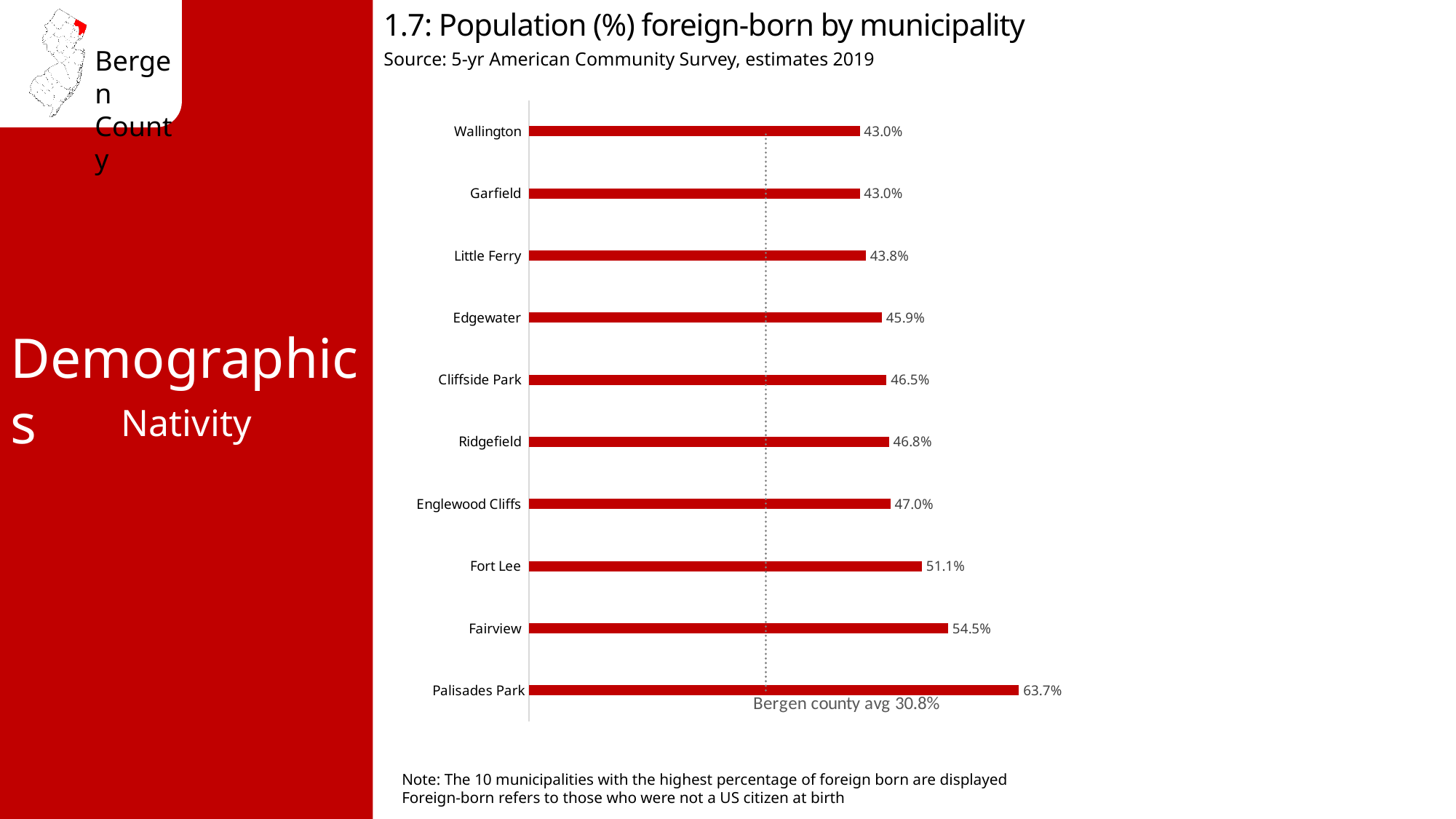
What is the difference between the foreign-born percentages of Palisades Park and Fairview? 9.2% What is the foreign-born population percentage for Fort Lee? 51.1% What is the title of the chart? 1.7: Population (%) foreign-born by municipality How many municipalities are shown on the chart? 10 What is the Bergen county average foreign-born percentage indicated by the dotted line? 30.8% What is the foreign-born population percentage for Edgewater? 45.9% Which municipality has the lowest value shown on the chart, Little Ferry or Edgewater? Little Ferry What is the difference between the foreign-born percentages of Fort Lee and Englewood Cliffs? 4.1% What is the foreign-born population percentage for Palisades Park? 63.7% What type of chart is used to display the data? Bar chart Which municipality has the highest percentage of foreign-born population? Palisades Park Which has a higher foreign-born percentage, Ridgefield or Cliffside Park? Ridgefield